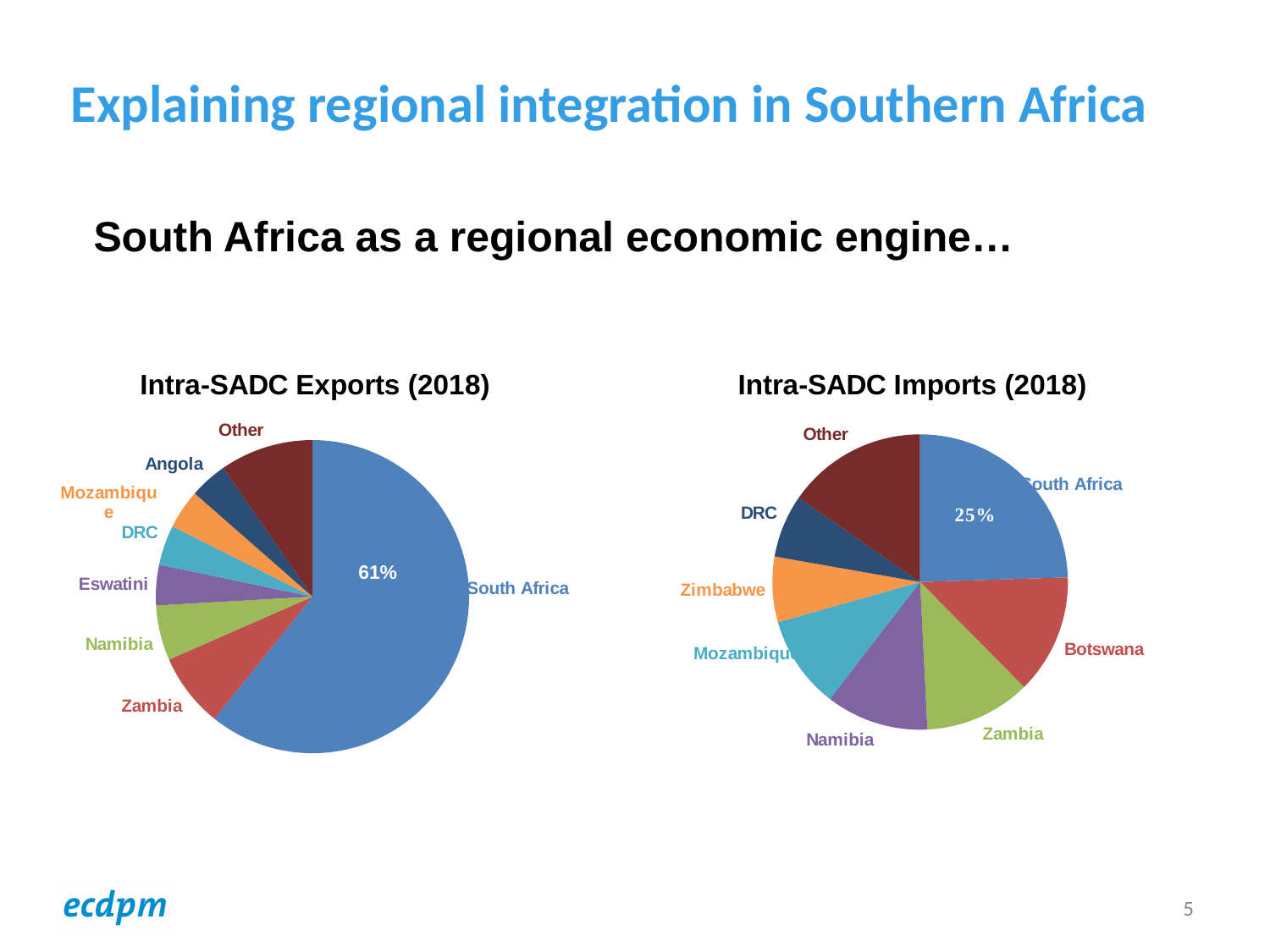
In the Intra-SADC Imports (2018) chart, which country has the largest slice? South Africa In the Intra-SADC Imports (2018) chart, which slice is larger, Botswana or Zimbabwe? Botswana By how many percentage points does South Africa's share in the Intra-SADC Exports (2018) chart exceed its share in the Intra-SADC Imports (2018) chart? 36 percentage points In the Intra-SADC Exports (2018) chart, what share of intra-SADC exports does South Africa account for? 61% How many slices does the Intra-SADC Imports (2018) pie chart have? 8 In the Intra-SADC Exports (2018) chart, which slice is larger, South Africa or Zambia? South Africa In the Intra-SADC Exports (2018) chart, which country has the largest slice? South Africa What kind of chart is the Intra-SADC Exports (2018) chart? Pie chart In the Intra-SADC Imports (2018) chart, what share of intra-SADC imports does South Africa account for? 25% Is South Africa's share larger in the Intra-SADC Exports (2018) chart or the Intra-SADC Imports (2018) chart? Intra-SADC Exports (2018) How many slices does the Intra-SADC Exports (2018) pie chart have? 8 What is the title of the pie chart on the right side of the slide? Intra-SADC Imports (2018)